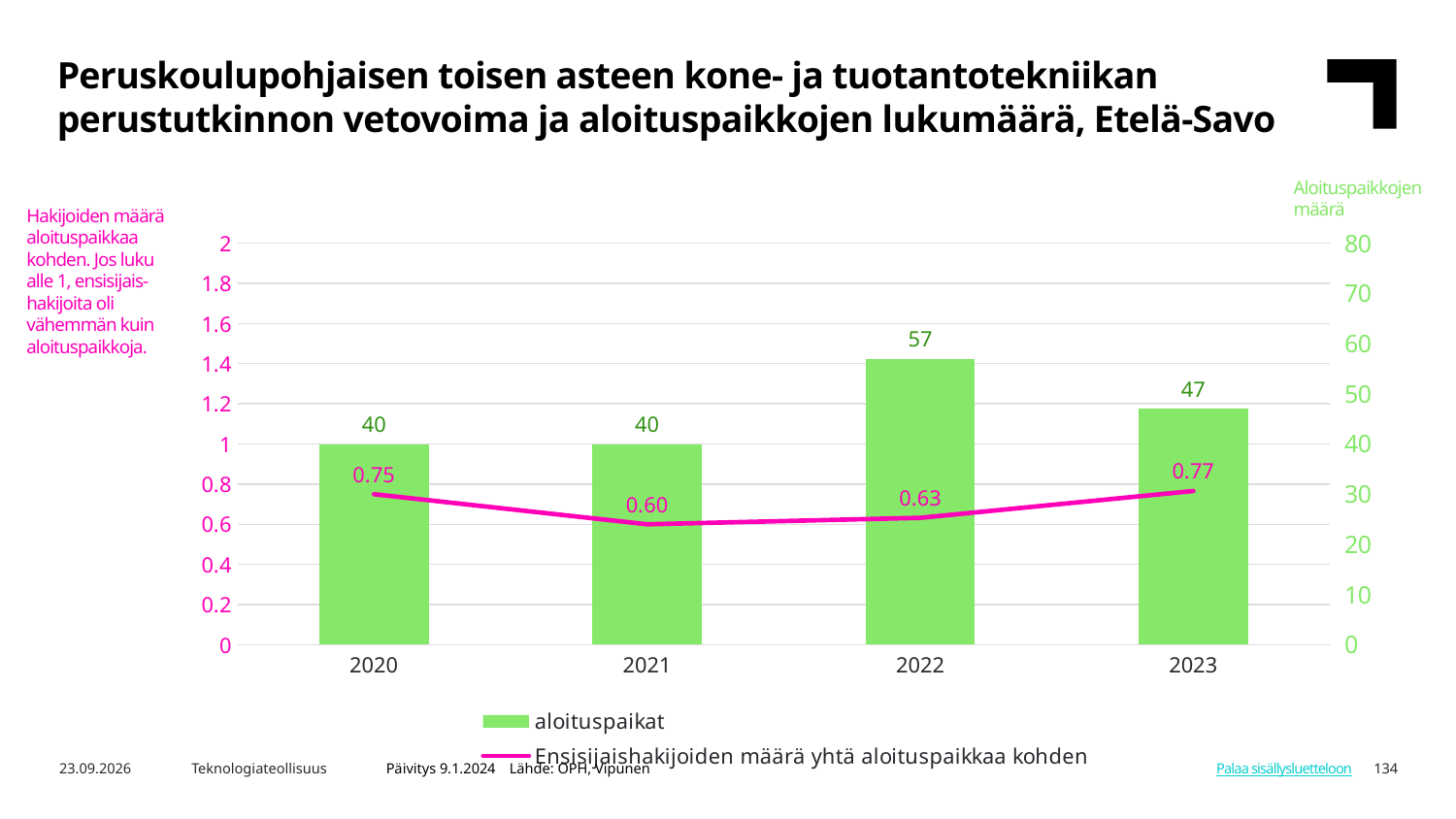
Which year has the lowest value of Ensisijaishakijoiden määrä yhtä aloituspaikkaa kohden? 2021 What is the value of Ensisijaishakijoiden määrä yhtä aloituspaikkaa kohden for 2021? 0.60 What is the value of aloituspaikat for 2023? 47 How many years are shown on the x axis? 4 What is the value of aloituspaikat for 2022? 57 What kind of chart is used to show the aloituspaikat series? bar chart Is the value of aloituspaikat for 2022 greater or less than 50? greater What is the difference in aloituspaikat between 2022 and 2023? 10 What colour is the line for Ensisijaishakijoiden määrä yhtä aloituspaikkaa kohden? pink Which year has the highest value of aloituspaikat? 2022 Is the value of Ensisijaishakijoiden määrä yhtä aloituspaikkaa kohden larger in 2020 or in 2023? 2023 How many series does the legend list? 2